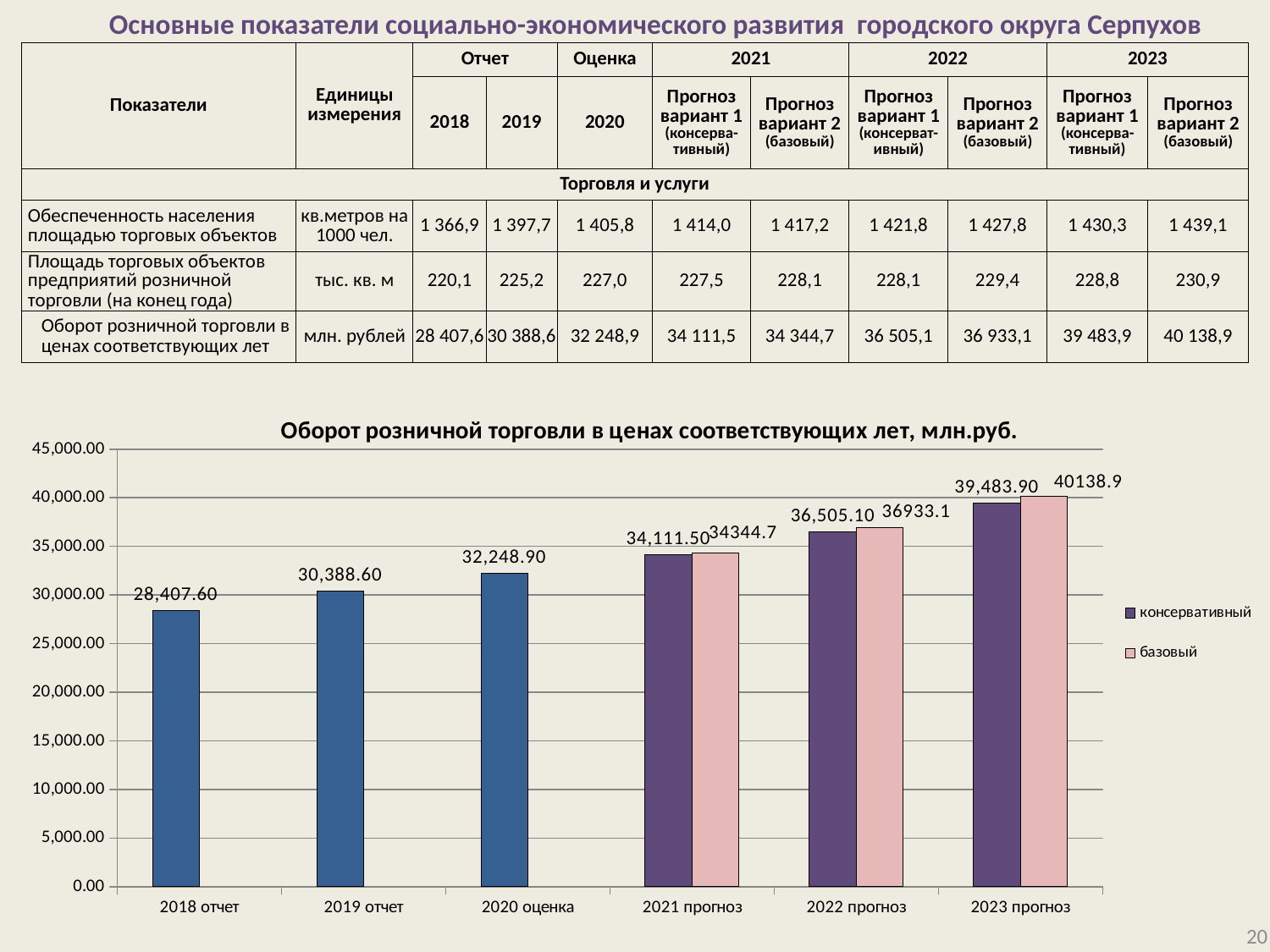
How many series does the chart legend list? 2 What is the value for 2018 отчет in the chart? 28,407.60 Which category has the lowest value in the chart? 2018 отчет Which category has the highest value in the chart? 2023 прогноз What is the value for 2020 оценка in the chart? 32,248.90 Is the value for 2019 отчет greater or less than 30,000.00? greater What is the difference between the базовый and консервативный values for 2021 прогноз? 233.2 What is the базовый value for 2022 прогноз in the chart? 36933.1 What is the консервативный value for 2023 прогноз in the chart? 39,483.90 Which is larger for 2022 прогноз: the консервативный or the базовый value? базовый What type of chart is shown on the slide? bar chart How many categories are shown on the x axis of the chart? 6